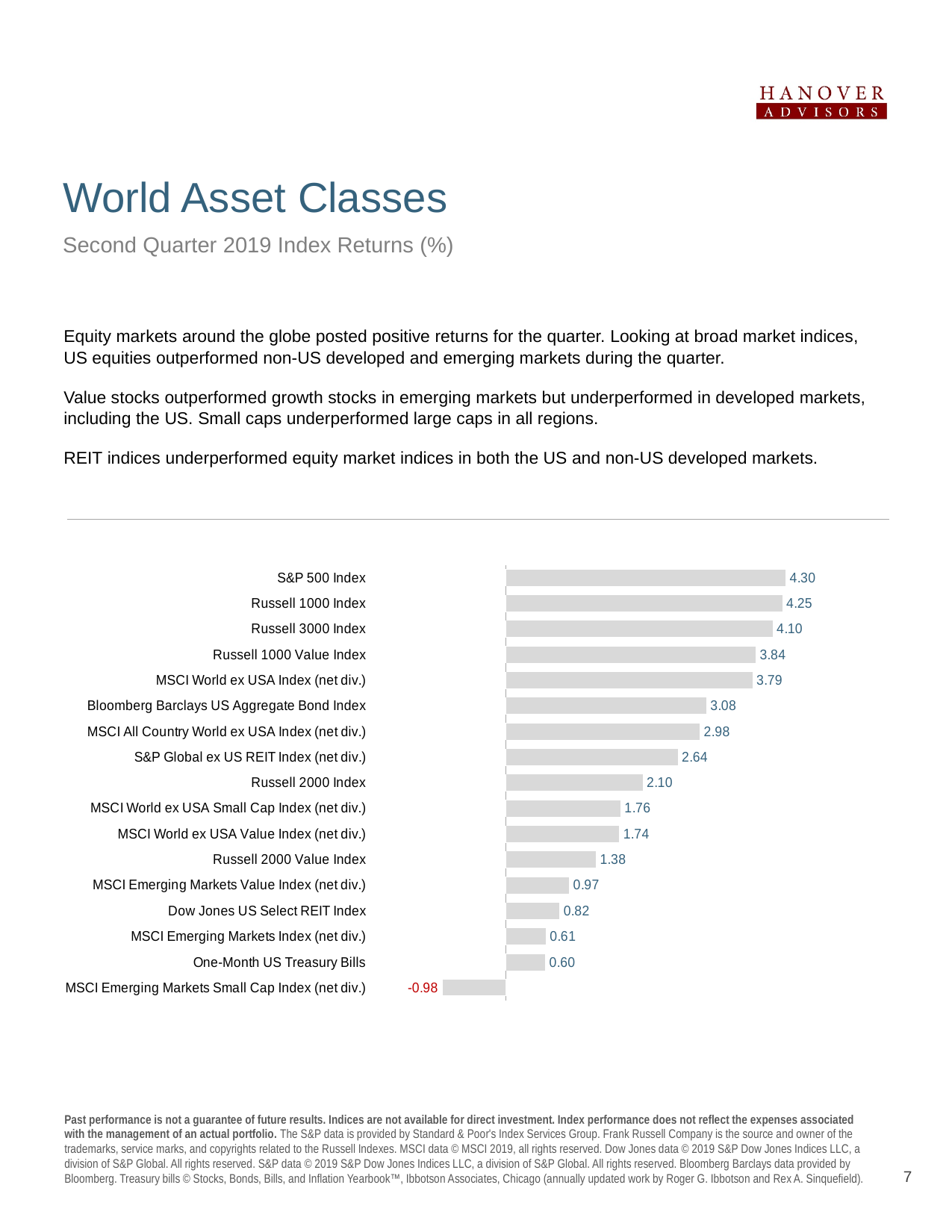
Which has the larger value, the Dow Jones US Select REIT Index or the S&P Global ex US REIT Index (net div.)? S&P Global ex US REIT Index (net div.) How many indices are plotted in the chart? 17 What is the difference between the values for the Russell 1000 Value Index and the Russell 2000 Value Index? 2.46 What is the value shown for the Bloomberg Barclays US Aggregate Bond Index? 3.08 What is the value shown for One-Month US Treasury Bills? 0.60 What is the difference between the values for the S&P 500 Index and the Russell 2000 Index? 2.20 What is the value shown for the S&P 500 Index? 4.30 What is the value shown for the MSCI Emerging Markets Small Cap Index (net div.)? -0.98 What kind of chart is shown on the slide? Bar chart Which index has the highest value in the chart? S&P 500 Index How many indices in the chart have a negative value? 1 Which index has the lowest value in the chart? MSCI Emerging Markets Small Cap Index (net div.)